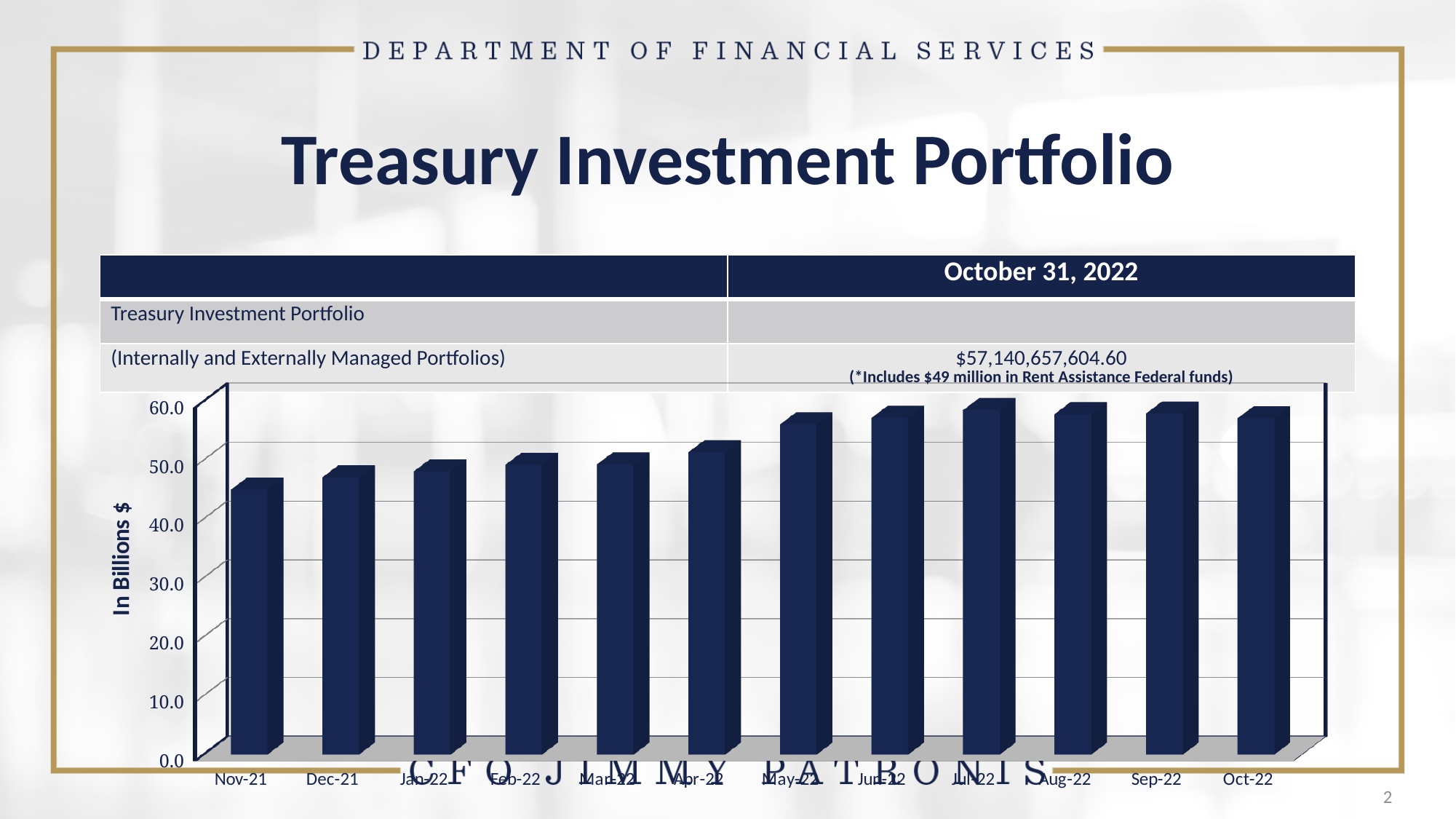
What kind of chart is shown on the slide? bar chart How many months are plotted on the x axis of the chart? 12 Is the value for Jul-22 greater or less than 50.0? greater What is the first month shown on the x axis of the chart? Nov-21 Is the value for Nov-21 greater or less than 50.0? less What is the label on the vertical axis of the chart? In Billions $ Which is larger, the value for Dec-21 or the value for Oct-22? Oct-22 Is the value for Oct-22 greater or less than 50.0? greater Which is larger, the value for Nov-21 or the value for Jul-22? Jul-22 Which month has the lowest bar in the chart? Nov-21 Do the bar values generally rise or fall from Nov-21 to Oct-22? rise